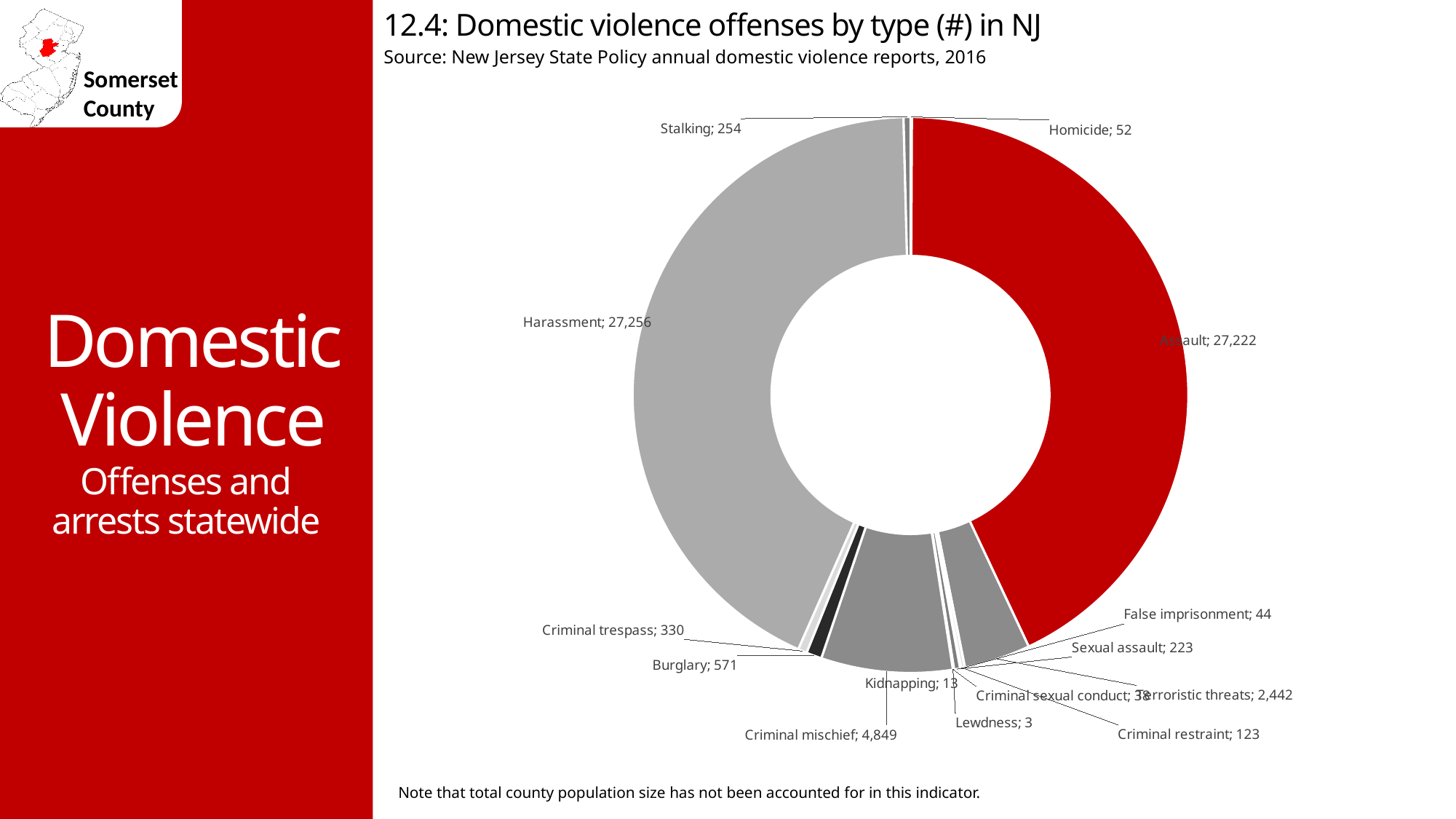
What is the value for Criminal mischief? 4,849 Which is larger, Stalking or Sexual assault? Stalking What is the value for Terroristic threats? 2,442 What is the difference between the Harassment and Assault values? 34 What type of chart is shown on the slide? doughnut chart What is the difference between Burglary and Criminal trespass? 241 How many offense categories are shown in the chart? 14 Which offense type has the highest value in the chart? Harassment What is the number of Assault offenses shown in the chart? 27,222 What is the value for Homicide? 52 Which offense type has the lowest value in the chart? Lewdness What is the number of Harassment offenses shown in the chart? 27,256